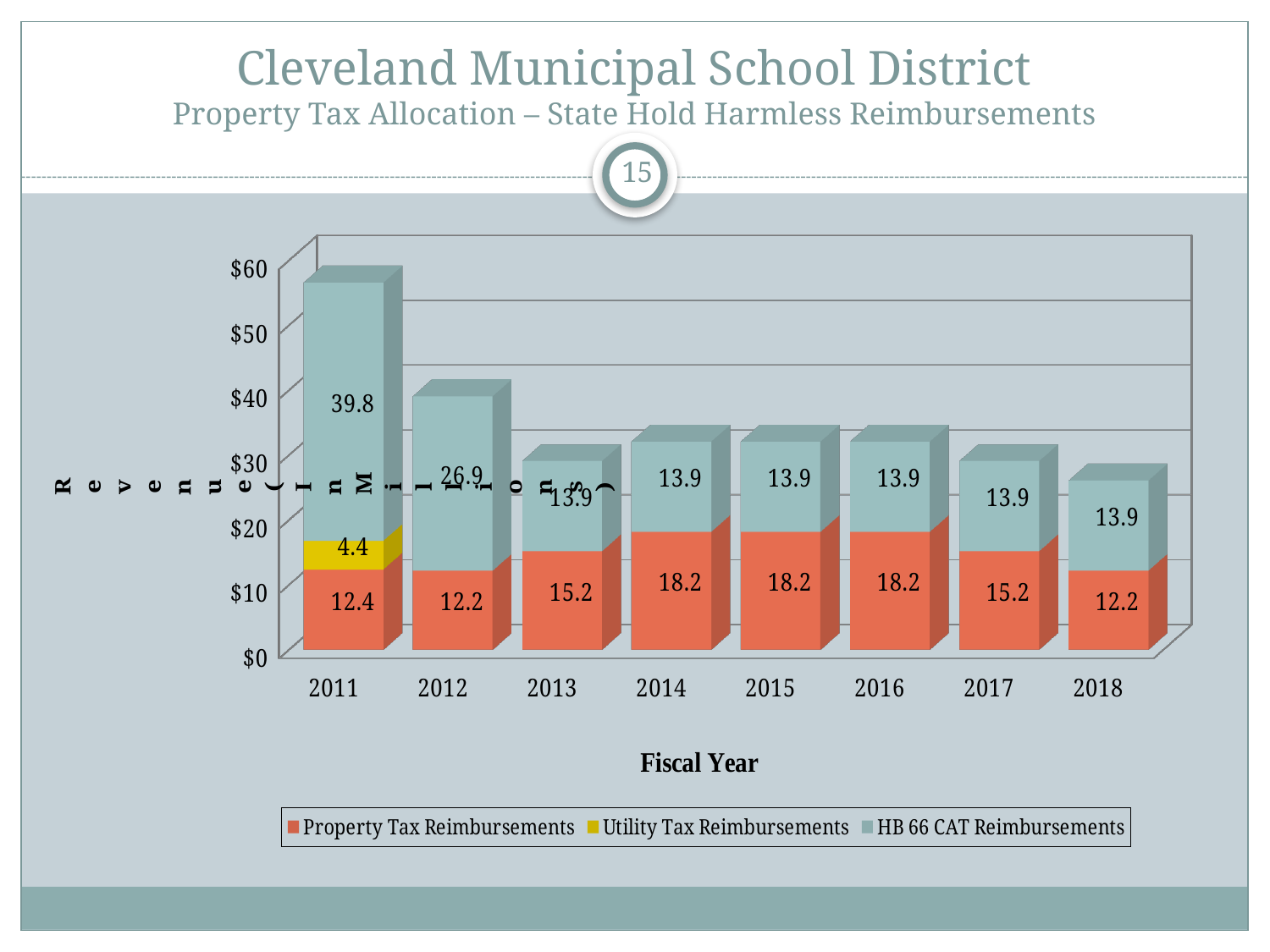
What is the value of HB 66 CAT Reimbursements for fiscal year 2012? 26.9 Is the total stacked bar for 2011 greater or less than $50? greater What is the value of HB 66 CAT Reimbursements for fiscal year 2011? 39.8 How much larger is HB 66 CAT Reimbursements in 2011 than in 2012? 12.9 Which is larger, Property Tax Reimbursements in 2013 or in 2018? 2013 What is the value of Property Tax Reimbursements for fiscal year 2014? 18.2 How many fiscal years are shown on the x axis? 8 How many series does the legend list? 3 Which fiscal year has the shortest stacked bar overall? 2018 Which fiscal year has the tallest stacked bar overall? 2011 What is the value of Utility Tax Reimbursements for fiscal year 2011? 4.4 What is the total of the stacked bar for fiscal year 2014? 32.1